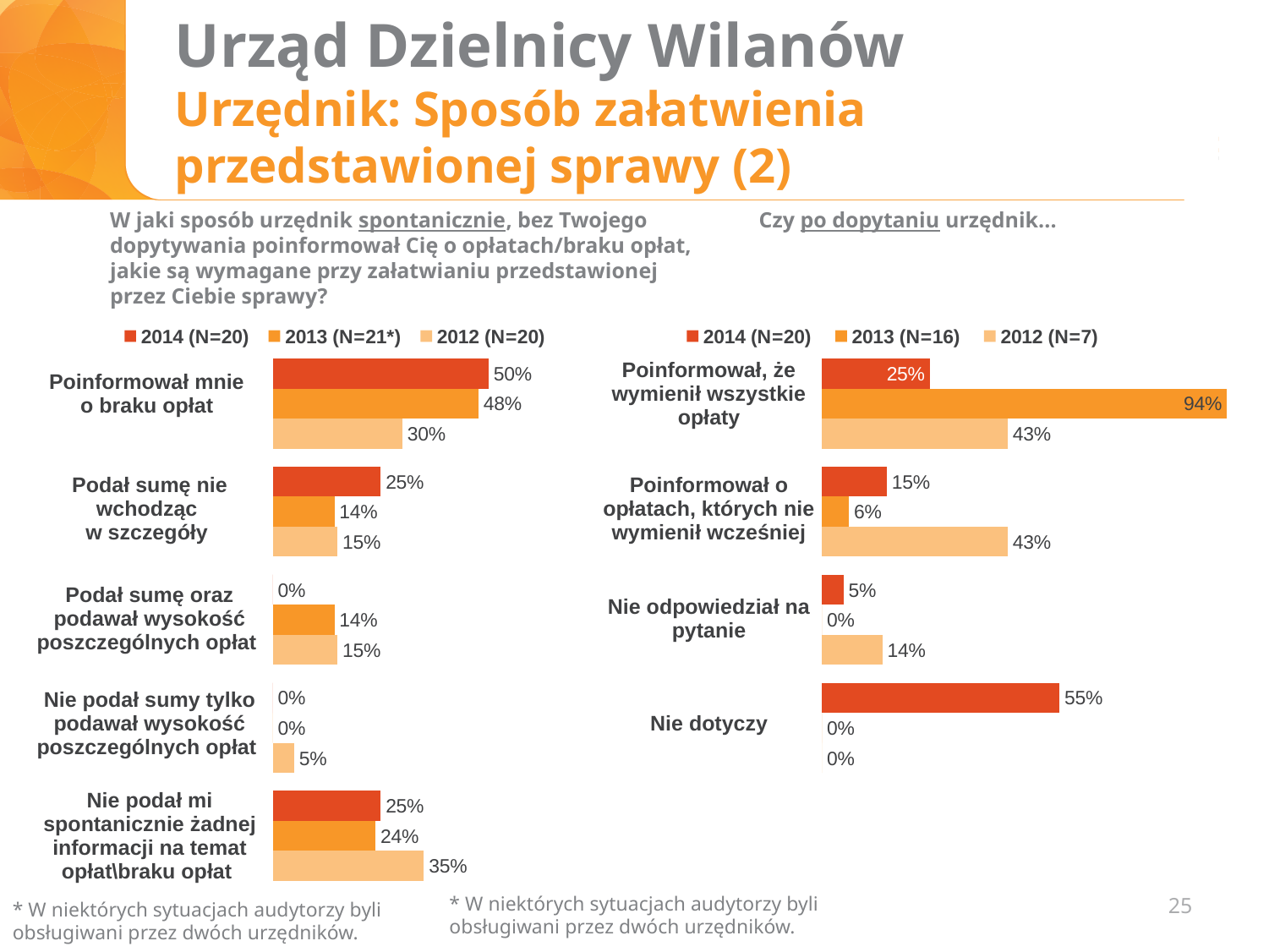
In the right chart, what sample size (N) is given for 2012 in the legend? N=7 What type of chart is the right chart? Bar chart In the right chart, what is the difference between the 2013 and 2012 values for "Poinformował, że wymienił wszystkie opłaty"? 51% In the left chart, what is the difference between the 2014 and 2012 values for "Poinformował mnie o braku opłat"? 20% In the right chart, which is larger for "Poinformował o opłatach, których nie wymienił wcześniej": the 2014 value or the 2012 value? 2012 In the left chart (spontaneous information about fees), what is the 2014 value for "Poinformował mnie o braku opłat"? 50% In the right chart ("Czy po dopytaniu urzędnik..."), what is the 2013 value for "Poinformował, że wymienił wszystkie opłaty"? 94% How many series does the legend of the right chart list? 3 In the left chart, what is the 2012 value for "Nie podał mi spontanicznie żadnej informacji na temat opłat\braku opłat"? 35% In the left chart, which category has the highest 2013 value? Poinformował mnie o braku opłat In the right chart, which category has the highest 2014 value? Nie dotyczy How many categories does the left chart show? 5